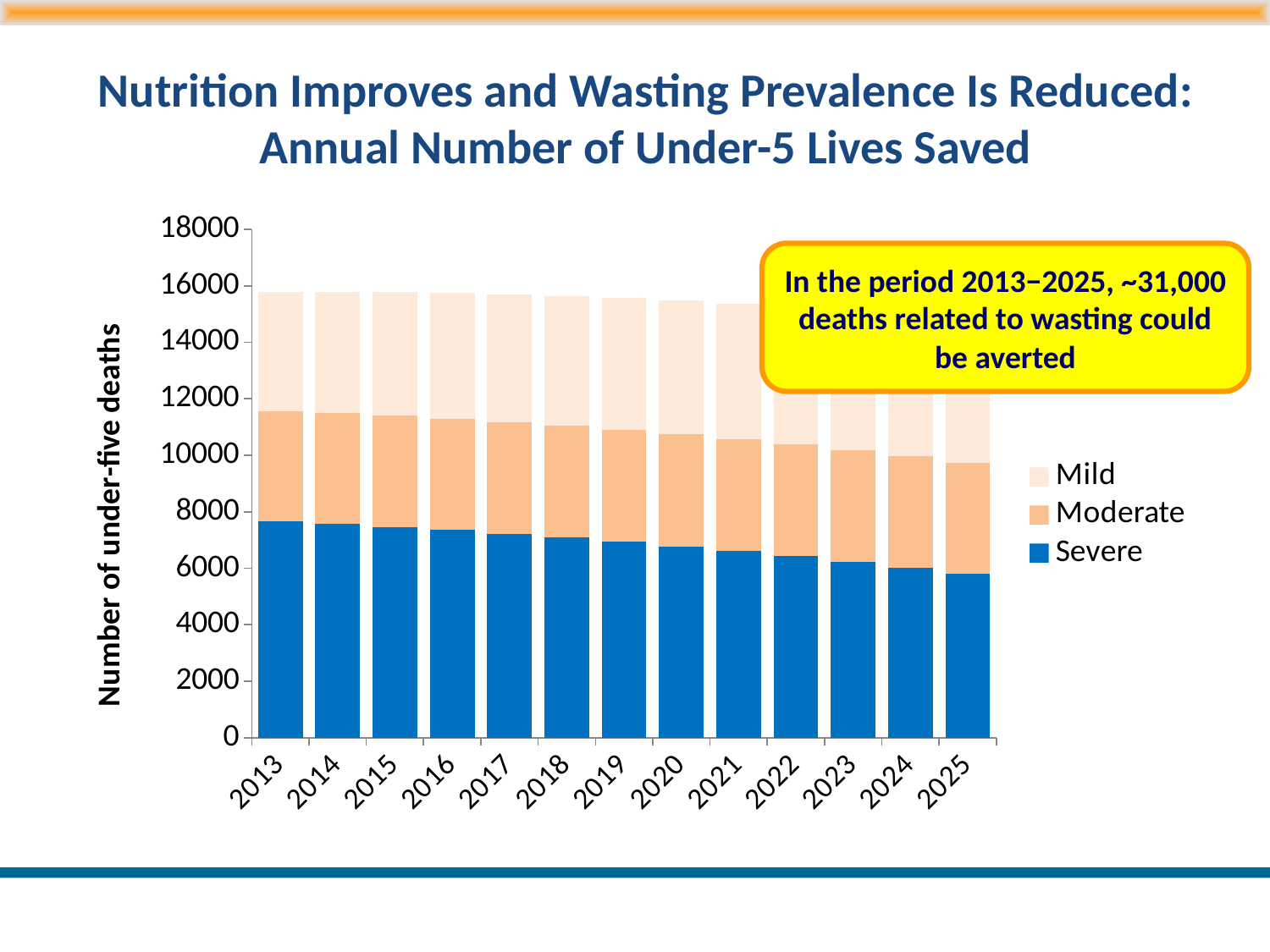
How many years are shown along the x axis of the chart? 13 What is the title of the vertical axis of the chart? Number of under-five deaths Which year has the larger Severe value, 2013 or 2025? 2013 What kind of chart is shown on the slide? Stacked bar chart Is the Severe value for 2013 greater or less than 6000? greater In which year is the Severe value highest? 2013 Does the Severe series rise or fall from 2013 to 2025? Fall Is the total stacked bar for 2013 greater or less than 14000? greater How many series does the chart's legend list? 3 Is the Severe value for 2025 greater or less than 8000? less Which series are listed in the chart's legend? Mild, Moderate, Severe In which year is the Severe value lowest? 2025